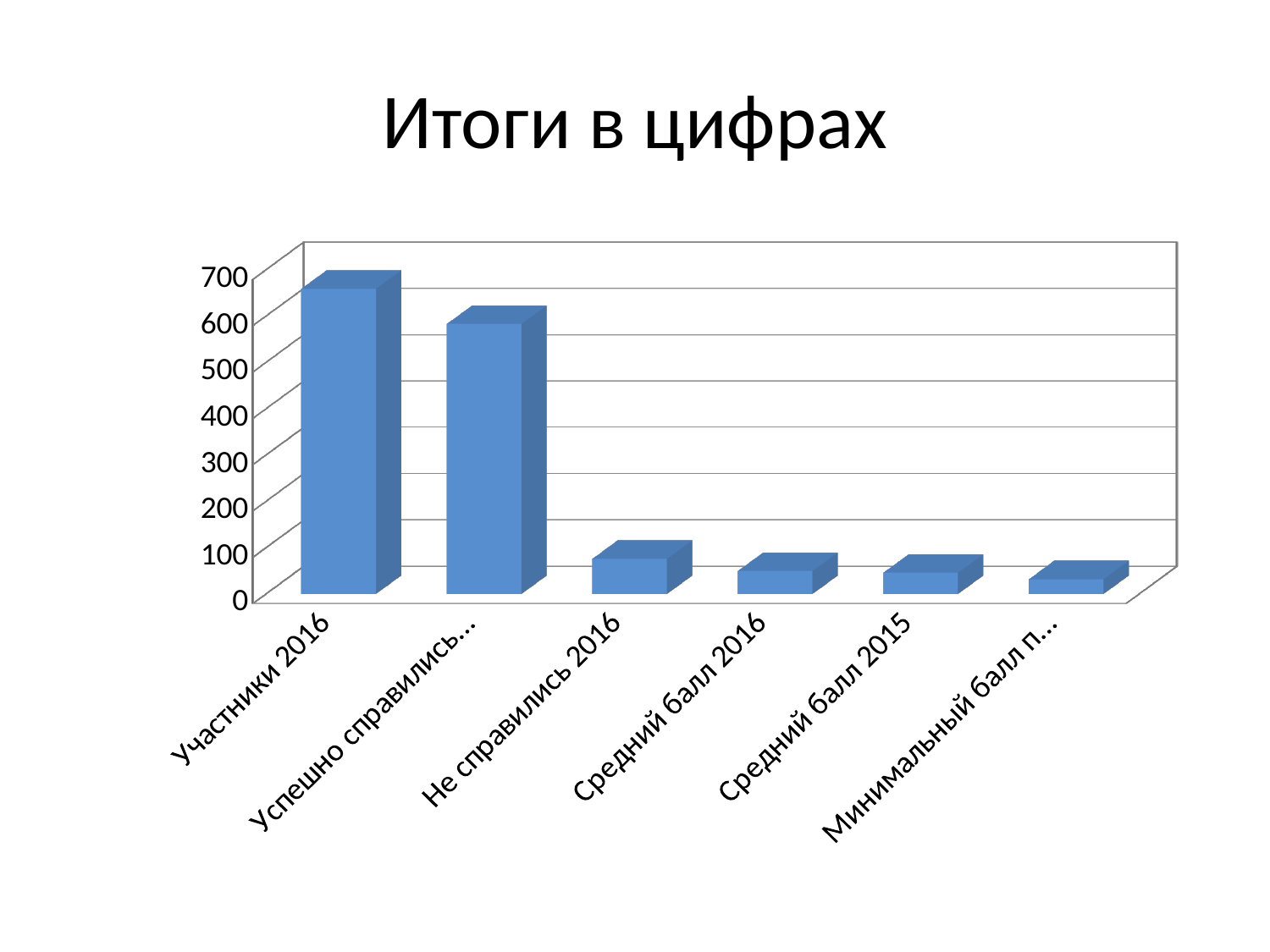
Which is larger, the value for Средний балл 2016 or the value for Участники 2016? Участники 2016 How many categories are plotted on the chart? 6 Which is larger, the value for Участники 2016 or the value for Не справились 2016? Участники 2016 What is the title of the slide with the chart? Итоги в цифрах What kind of chart is shown on the slide? bar chart Is the value for Средний балл 2015 greater or less than 200? less Which category has the highest value on the chart? Участники 2016 What is the highest value shown on the vertical axis? 700 Is the value for Участники 2016 greater or less than 600? greater Do the bar values rise or fall moving from left to right along the x axis? fall Is the value for Средний балл 2016 greater or less than 100? less